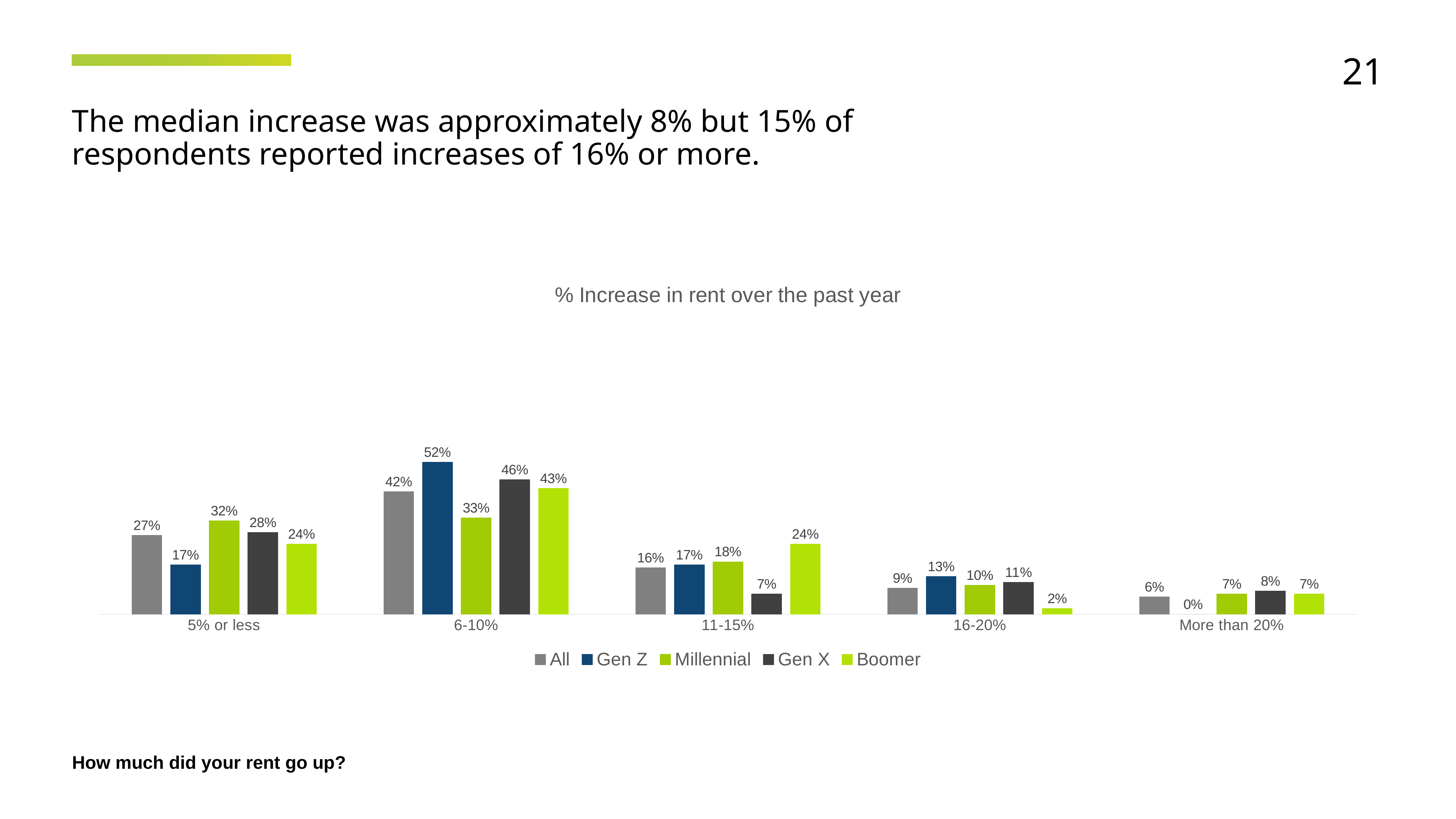
How many categories are shown on the x axis? 5 What is the difference between the Gen Z and Millennial values in the 6-10% category? 19% Which category has the highest value for the All series? 6-10% How many series does the legend list? 5 What is the value for Gen Z in the 6-10% category? 52% What is the value for Boomer in the 11-15% category? 24% Which series has the lowest value in the 16-20% category? Boomer Does the All series rise or fall from the 6-10% category to the More than 20% category? Fall What is the value for Gen Z in the More than 20% category? 0% What kind of chart is shown on the slide? Bar chart Which is larger in the 5% or less category: Millennial or Gen Z? Millennial What is the title of the chart? % Increase in rent over the past year